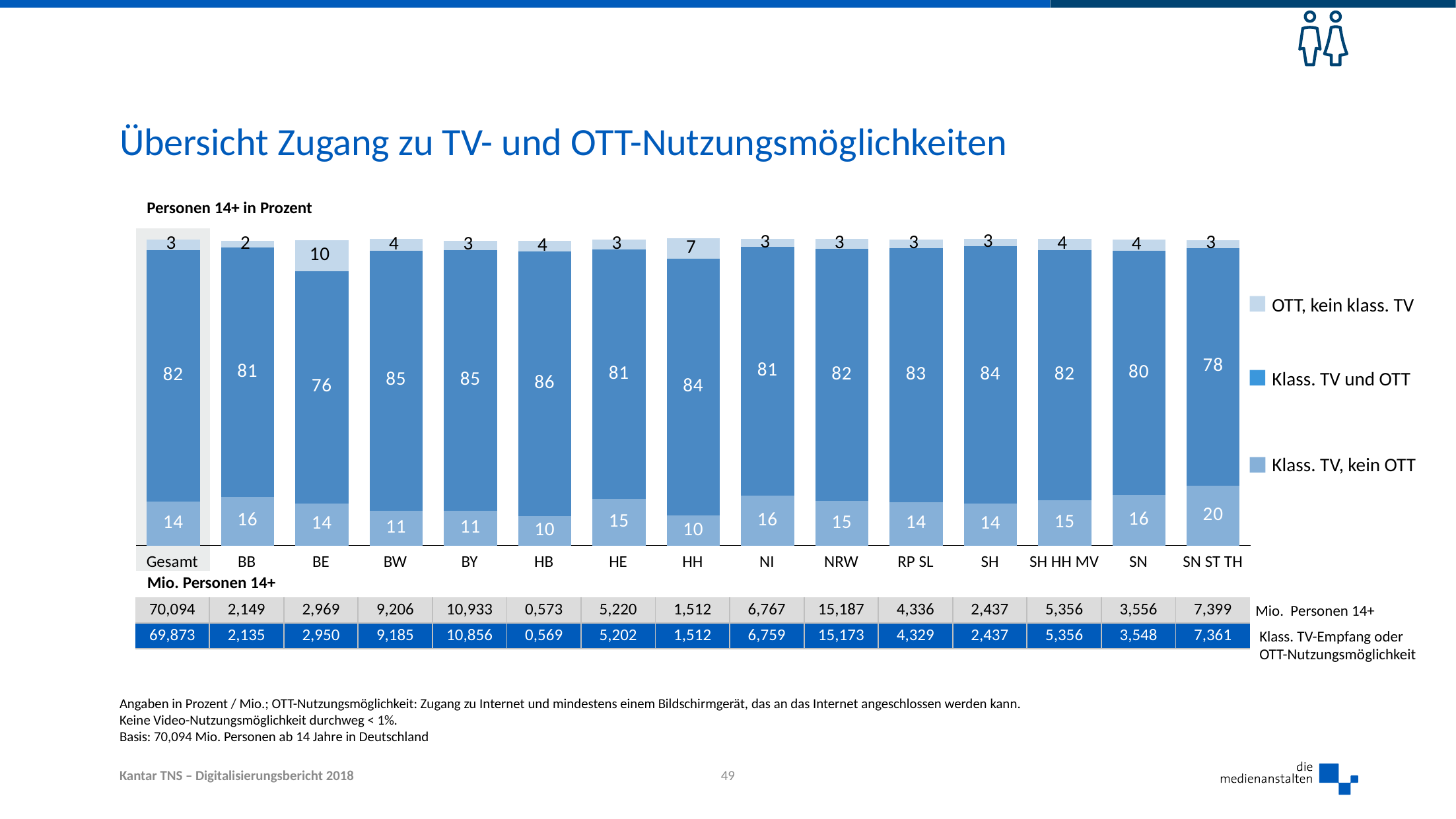
What is the value for "Klass. TV, kein OTT" for SN ST TH? 20 Which category has the lowest value for "Klass. TV und OTT"? BE What is the value for "OTT, kein klass. TV" for HH? 7 Which is larger: the "Klass. TV und OTT" value for BW or for SN? BW Which category has the highest value for "Klass. TV und OTT"? HB Which category has the highest value for "OTT, kein klass. TV"? BE What kind of chart is shown on the slide? Stacked bar chart How many series does the legend list? 3 What is the difference between the "Klass. TV, kein OTT" values for SN ST TH and HB? 10 What is the value for "Klass. TV und OTT" for BE? 76 How many categories are shown on the x axis of the chart? 15 What is the total of the stacked bar for Gesamt? 99